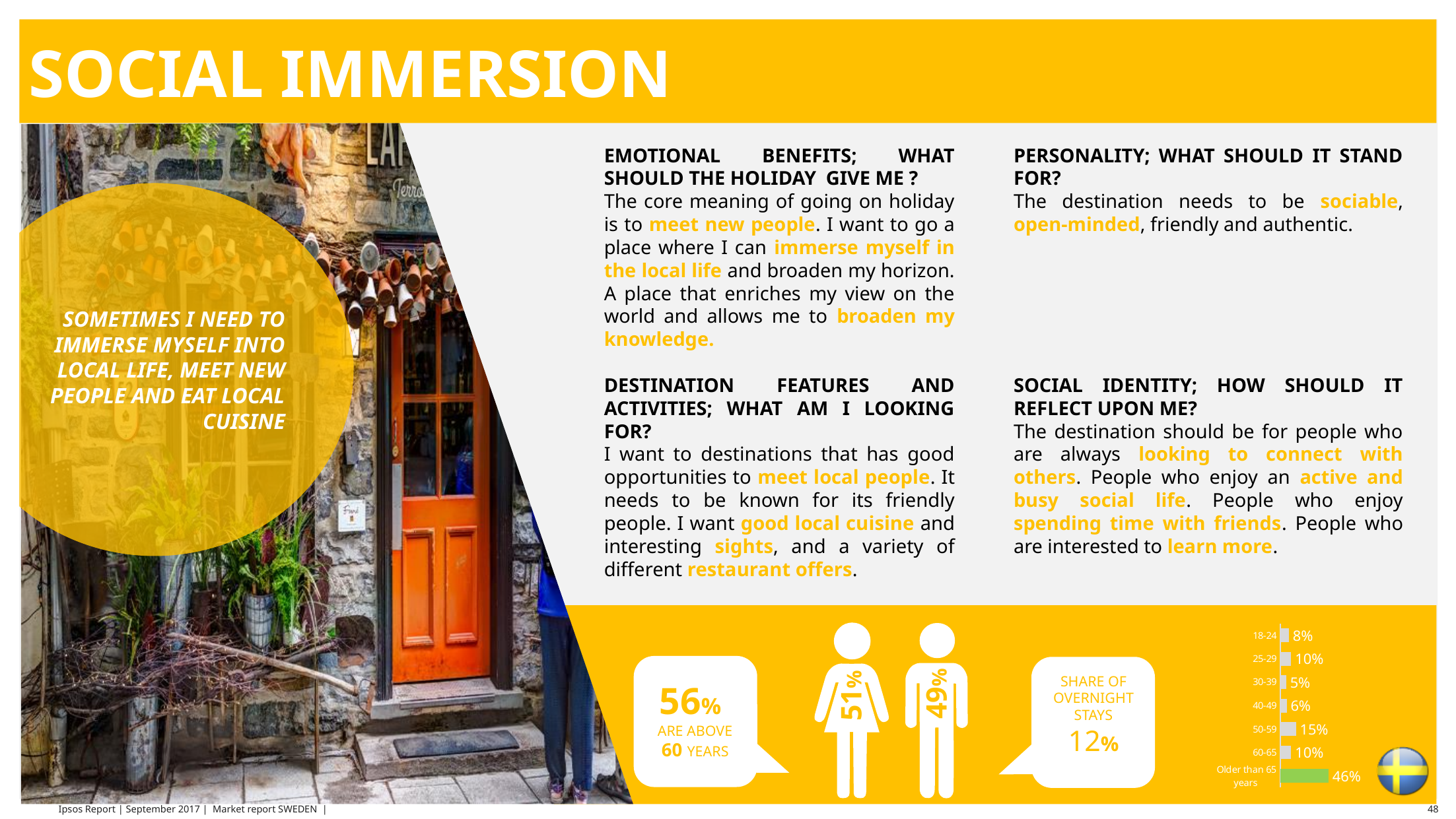
In the age-group bar chart at the bottom right, which age group has the lowest value? 30-39 In the age-group bar chart at the bottom right, what is the difference between the 60-65 value and the 18-24 value? 2% In the age-group bar chart at the bottom right, how many age groups are shown? 7 In the age-group bar chart at the bottom right, what is the value for the 50-59 age group? 15% In the age-group bar chart at the bottom right, which is larger: the value for 25-29 or the value for 30-39? 25-29 What type of chart is the age-group chart at the bottom right of the slide? Bar chart In the age-group bar chart at the bottom right, what is the value for the 40-49 age group? 6% In the age-group bar chart at the bottom right, what is the value for the 'Older than 65 years' group? 46% In the age-group bar chart at the bottom right, which bar is coloured green rather than grey? Older than 65 years In the age-group bar chart at the bottom right, what is the value for the 18-24 age group? 8% In the age-group bar chart at the bottom right, which age group has the highest value? Older than 65 years In the age-group bar chart at the bottom right, what is the difference between the 'Older than 65 years' value and the 50-59 value? 31%